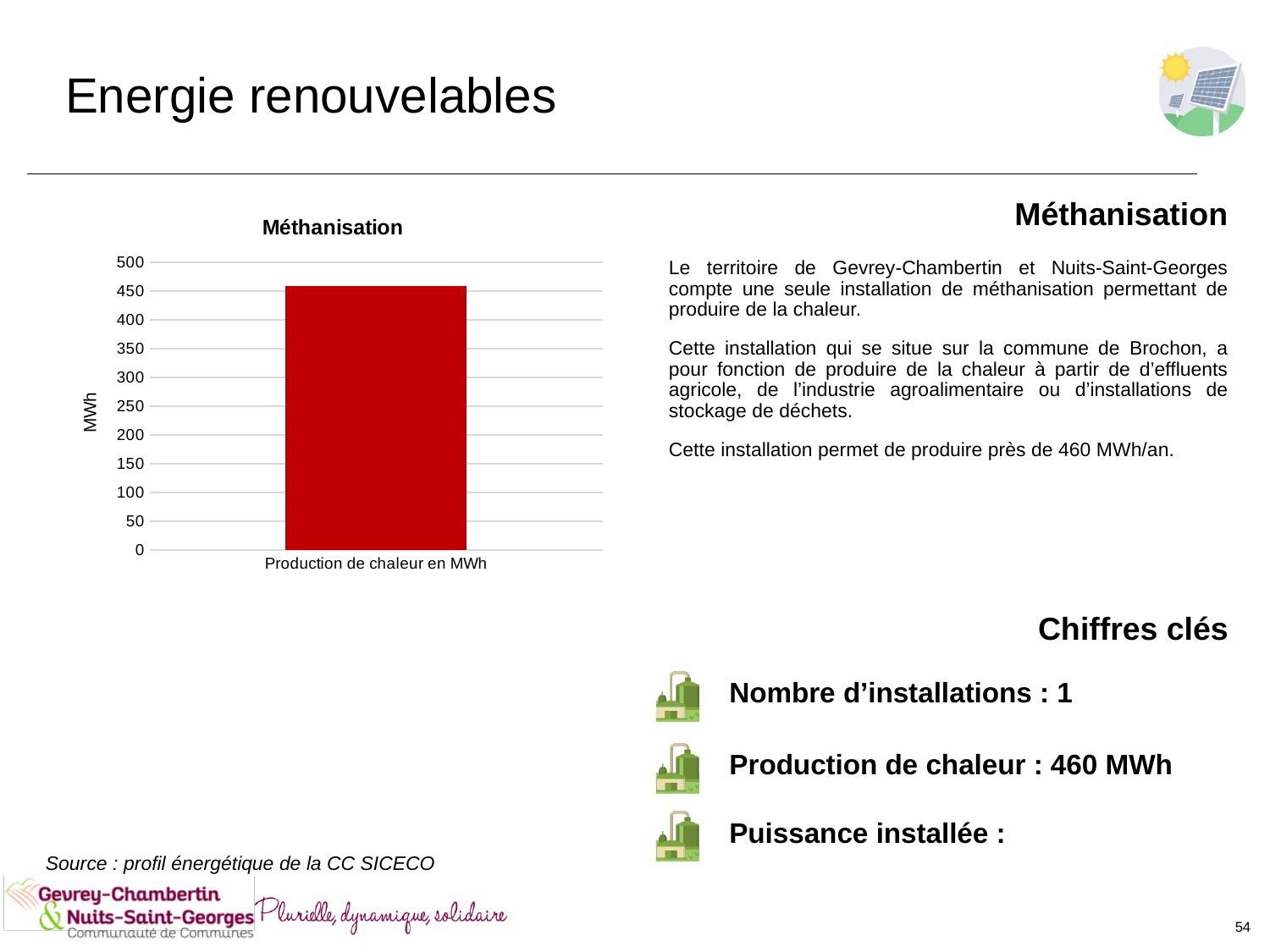
What unit is shown on the y axis of the chart? MWh What is the title of the chart? Méthanisation Is the value for Production de chaleur en MWh greater or less than 300? greater What is the highest tick value shown on the y axis of the chart? 500 Is the value for Production de chaleur en MWh greater or less than 500? less How many bars does the chart show? 1 What kind of chart is shown on the slide? bar chart What is the label of the category on the x axis of the chart? Production de chaleur en MWh Is the value for Production de chaleur en MWh greater or less than 400? greater